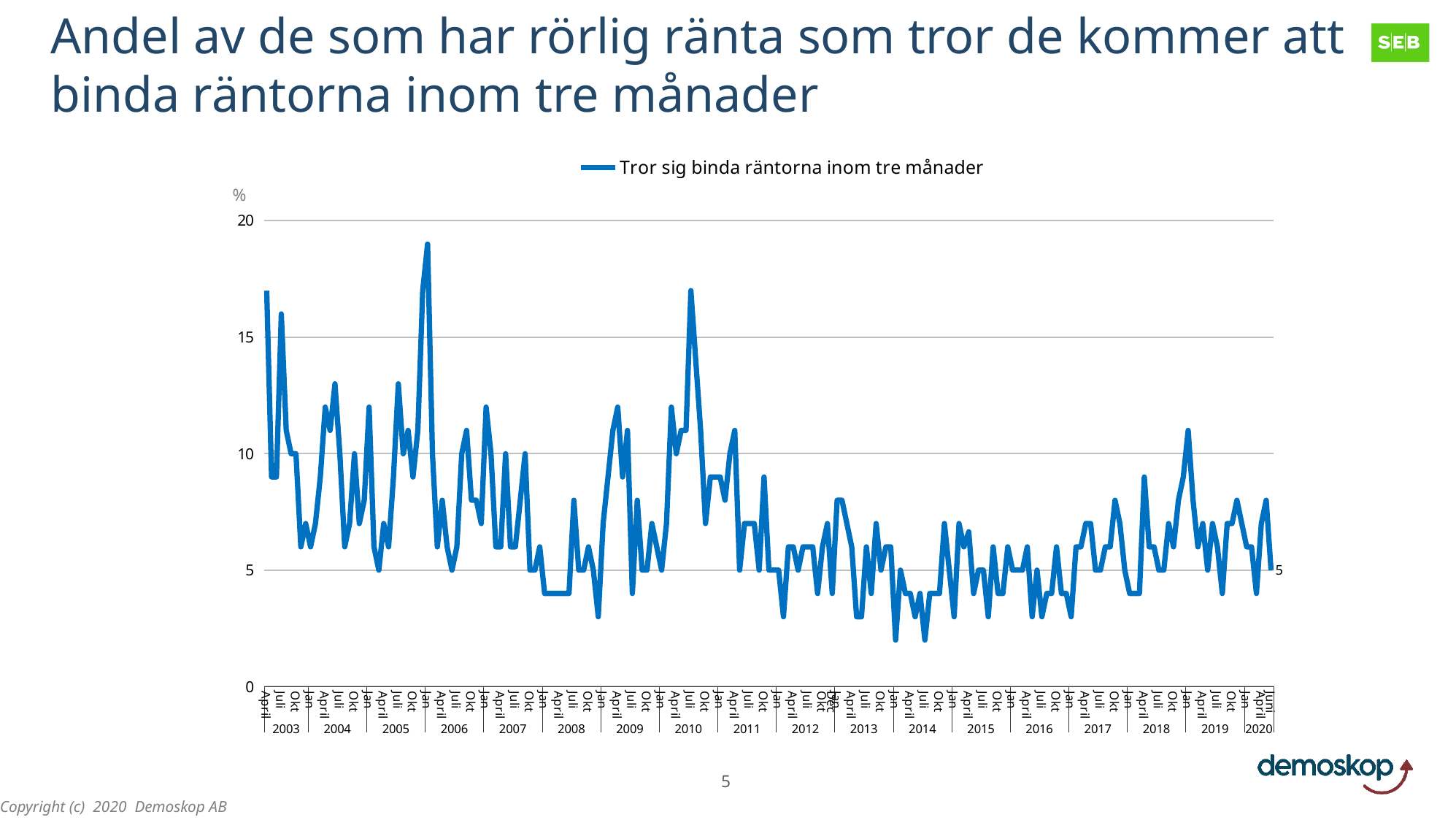
What unit is shown on the vertical axis? % What is the value printed at the last data point (Juni 2020)? 5 Overall, do the values rise or fall from 2003 to 2020? fall In which year does the line reach its highest point? 2006 How many series does the legend list? 1 How many years are labelled along the x axis? 18 Is the value for Juni 2020 greater or less than 10? less Is the peak value in 2010 greater or less than 15? greater Is the highest value reached in 2006 greater or less than 15? greater What kind of chart is shown on the slide? line chart What is the legend entry for the plotted series? Tror sig binda räntorna inom tre månader